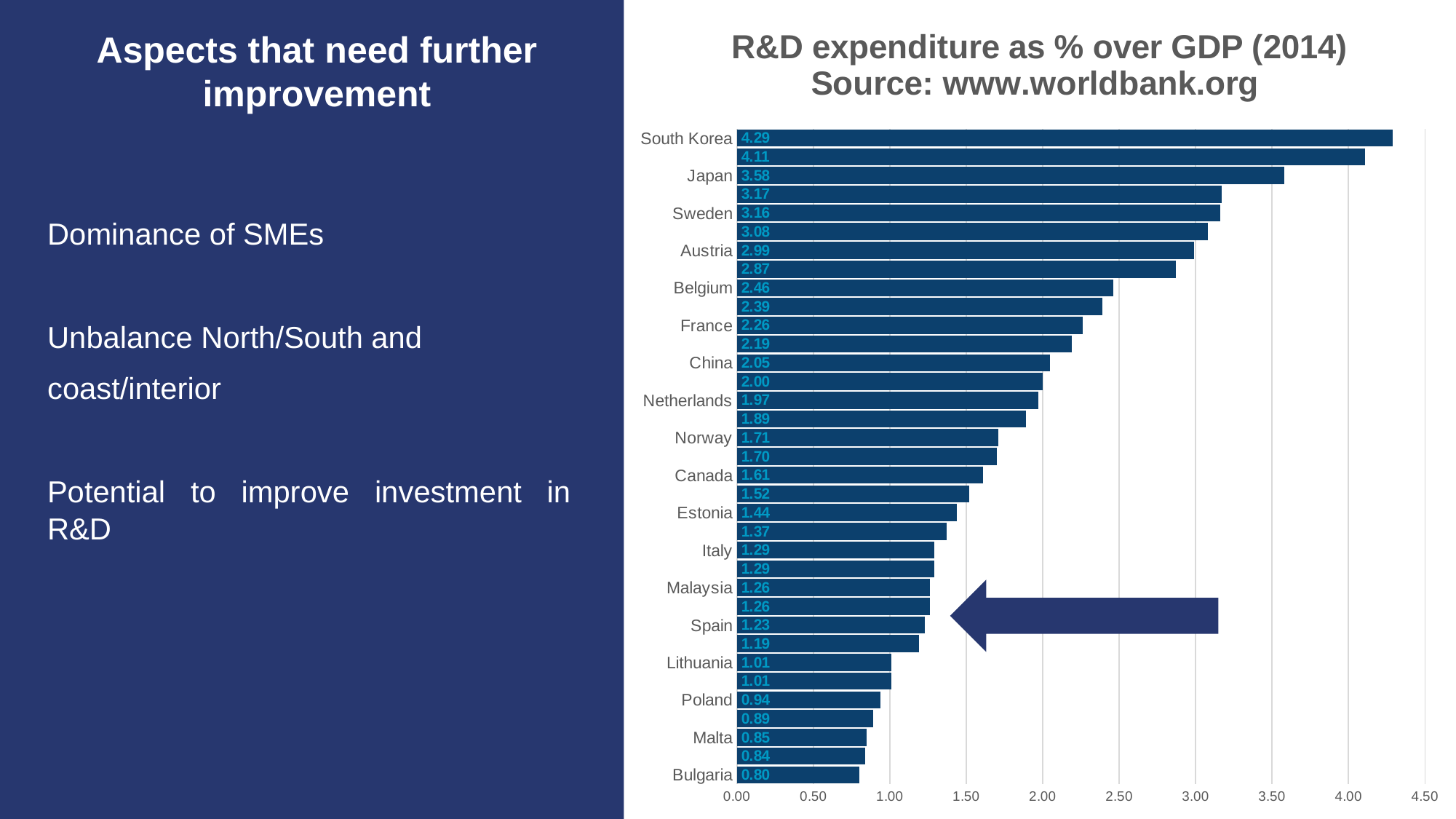
What is the value shown for China? 2.05 What is the value shown for Bulgaria? 0.80 Which has a higher value, Belgium or France? Belgium Which country has the lowest R&D expenditure as % of GDP? Bulgaria Which has a higher value, Italy or Spain? Italy What is the R&D expenditure as % of GDP for South Korea? 4.29 What kind of chart is shown on the slide? Bar chart What is the value shown for Spain? 1.23 What is the difference between the values for Japan and Sweden? 0.42 What is the difference between the values for South Korea and Japan? 0.71 Which country has the highest R&D expenditure as % of GDP? South Korea What is the title of the chart? R&D expenditure as % over GDP (2014) Source: www.worldbank.org